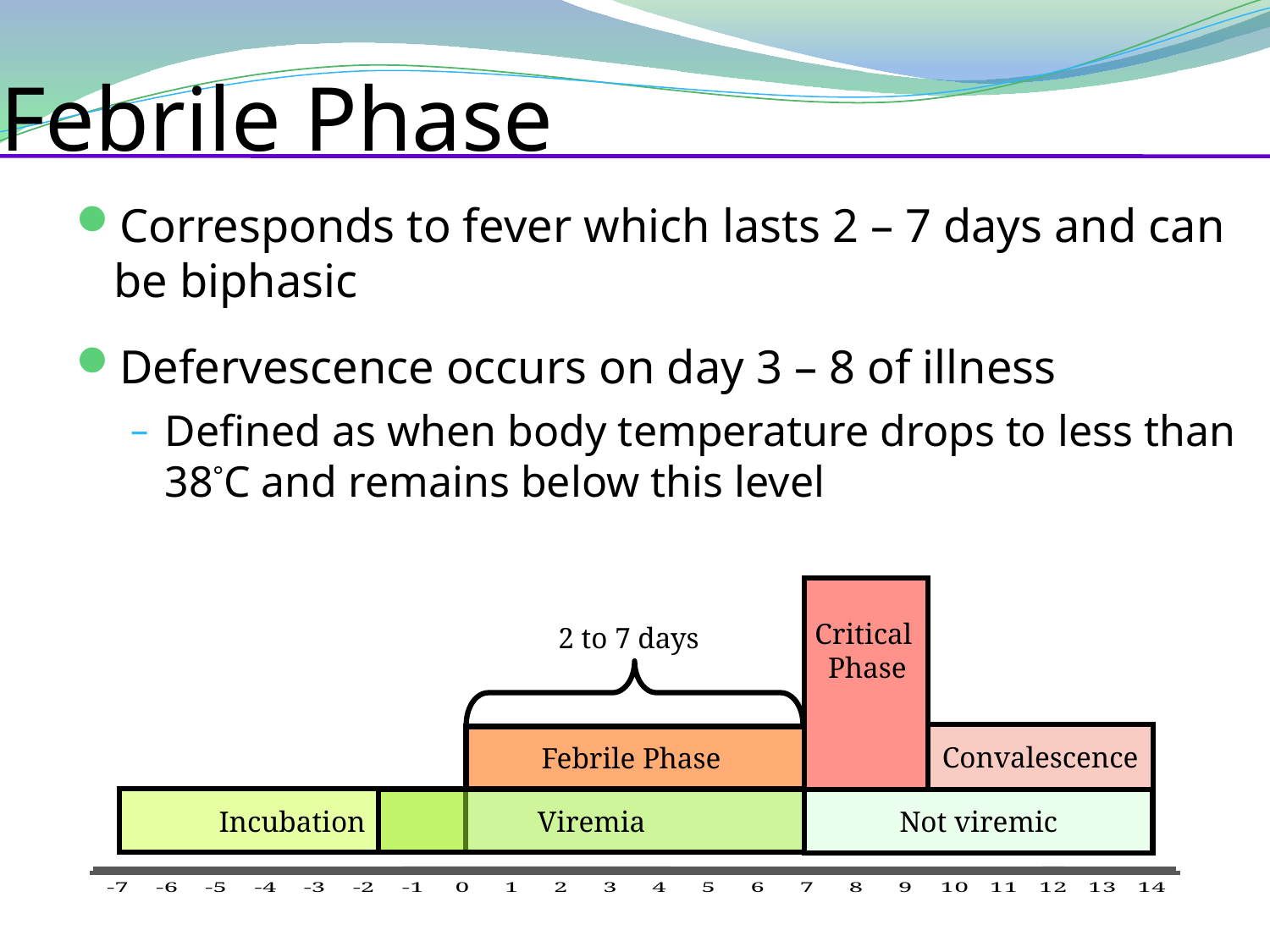
On what day of the axis does the Febrile Phase block end? 7 According to the bracket annotation above the Febrile Phase block, how long does the febrile phase last? 2 to 7 days How many labeled blocks are there in the timeline diagram? 6 What colour is the Critical Phase block in the timeline diagram? Red Which block in the bottom row of the timeline covers days 7 to 14? Not viremic What is the lowest value shown on the day axis of the timeline diagram? -7 On what day of the axis does the Incubation block begin? -7 What is the highest value shown on the day axis of the timeline diagram? 14 On what day of the axis does the Febrile Phase block begin? 0 Which block in the bottom row of the timeline covers days 0 to 7? Viremia Which labeled block comes immediately after the Critical Phase block on the timeline? Convalescence Which labeled block in the timeline diagram is the tallest? Critical Phase